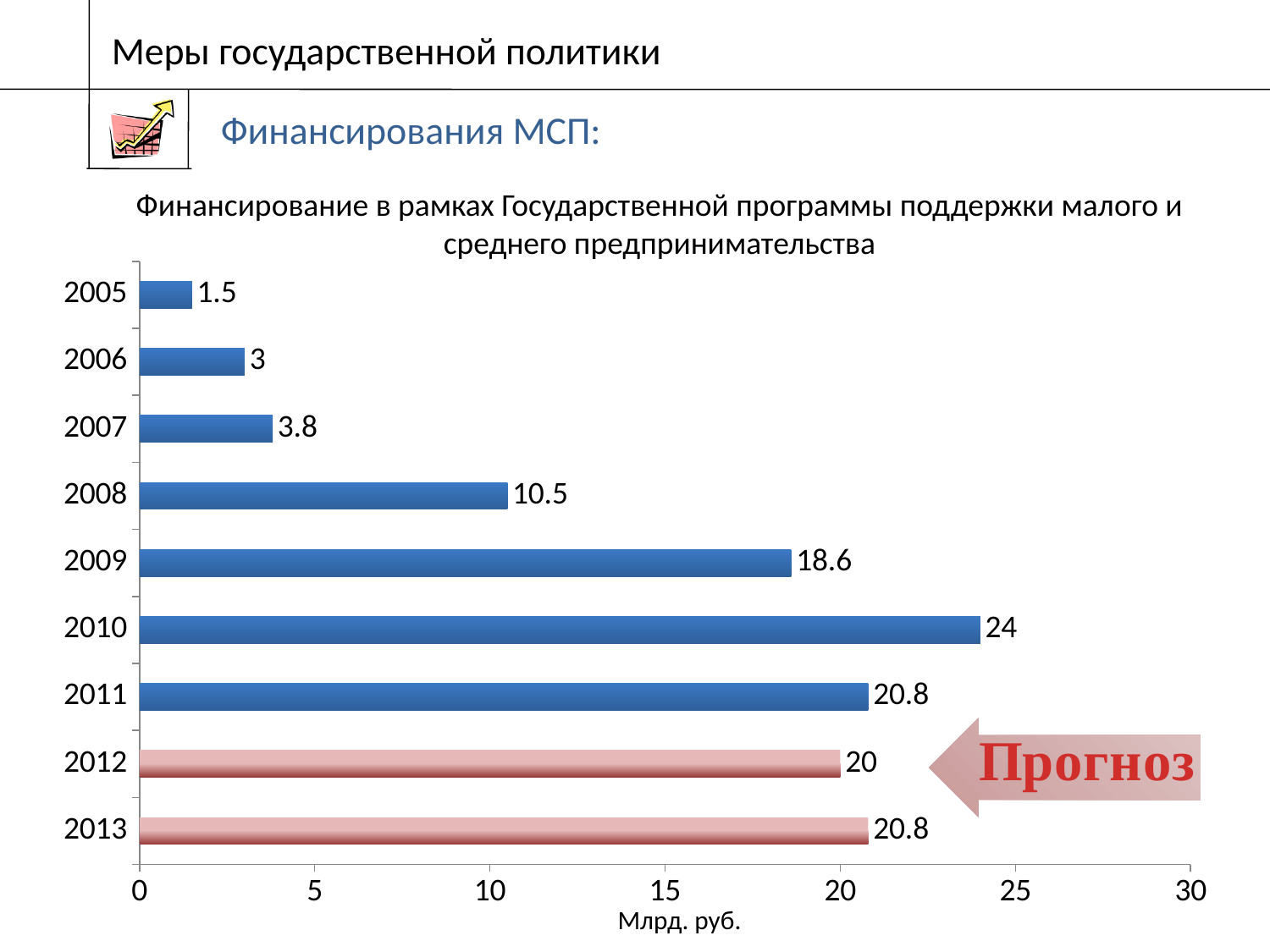
Which years are shown with pink bars marked as forecast (Прогноз)? 2012 and 2013 What is the value for 2008? 10.5 What is the value for 2010? 24 What kind of chart is this? bar chart What is the difference between the values for 2010 and 2009? 5.4 What unit is shown on the horizontal axis label? Млрд. руб. What is the value for 2005? 1.5 Which year has the highest value? 2010 Is the value for 2011 greater or less than 20? greater How many years are shown on the chart? 9 Which year has the lowest value? 2005 Which is larger, the value for 2008 or the value for 2009? 2009